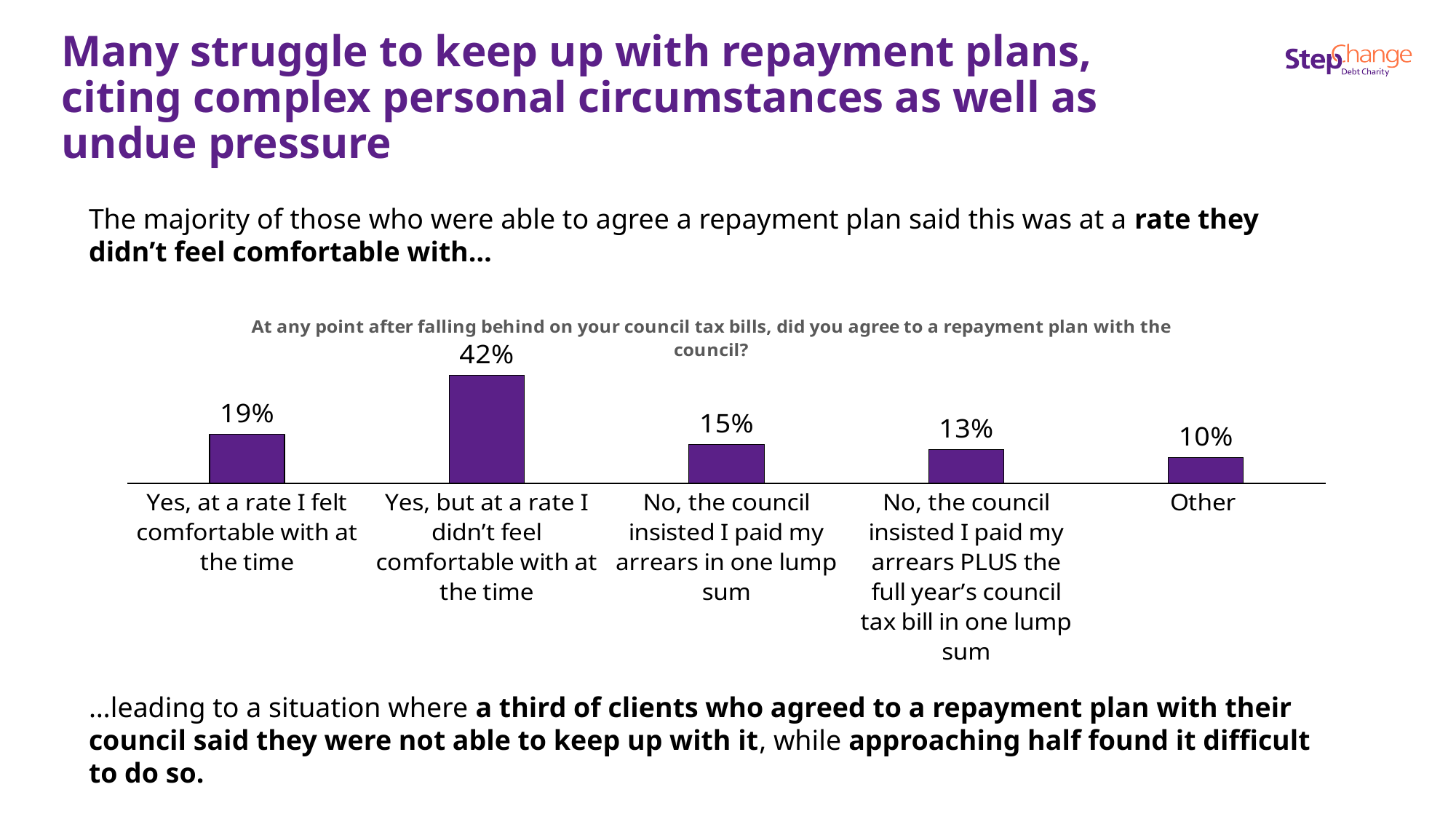
Which is larger: the value for 'No, the council insisted I paid my arrears in one lump sum' or the value for 'No, the council insisted I paid my arrears PLUS the full year's council tax bill in one lump sum'? No, the council insisted I paid my arrears in one lump sum What colour are the bars in the chart? Purple What is the difference in percentage points between 'Yes, but at a rate I didn't feel comfortable with at the time' and 'Yes, at a rate I felt comfortable with at the time'? 23 percentage points What percentage of respondents said they agreed to a repayment plan at a rate they felt comfortable with at the time? 19% What is the title of the chart? At any point after falling behind on your council tax bills, did you agree to a repayment plan with the council? What percentage of respondents said the council insisted they paid their arrears in one lump sum? 15% What percentage of respondents said they agreed to a repayment plan but at a rate they didn't feel comfortable with at the time? 42% What type of chart is shown on the slide? Bar chart How many response categories are shown in the chart? 5 What percentage of respondents answered 'Other'? 10% Which response category has the lowest value in the chart? Other Which response category has the highest value in the chart? Yes, but at a rate I didn't feel comfortable with at the time